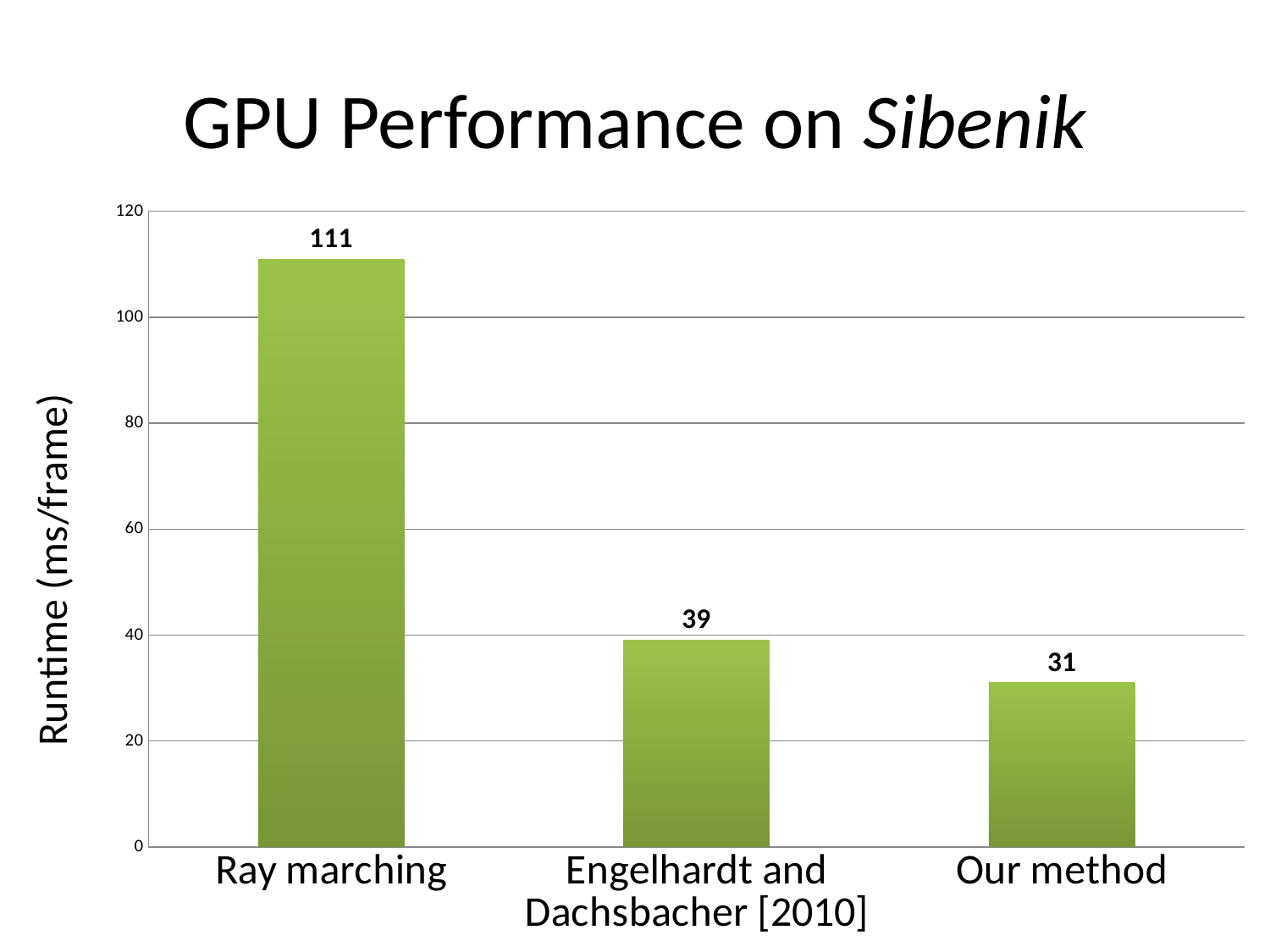
Is the value for Ray marching greater or less than 100? greater How many methods are compared in the chart? 3 What is the runtime for Our method? 31 Which method has the lowest runtime? Our method What is the difference in runtime between Engelhardt and Dachsbacher [2010] and Our method? 8 What kind of chart is shown on the slide? bar chart What is the difference in runtime between Ray marching and Our method? 80 Which method has the highest runtime? Ray marching What is the runtime for Engelhardt and Dachsbacher [2010]? 39 Which has a larger runtime, Engelhardt and Dachsbacher [2010] or Our method? Engelhardt and Dachsbacher [2010] What is the runtime for Ray marching? 111 What is the label of the y axis? Runtime (ms/frame)